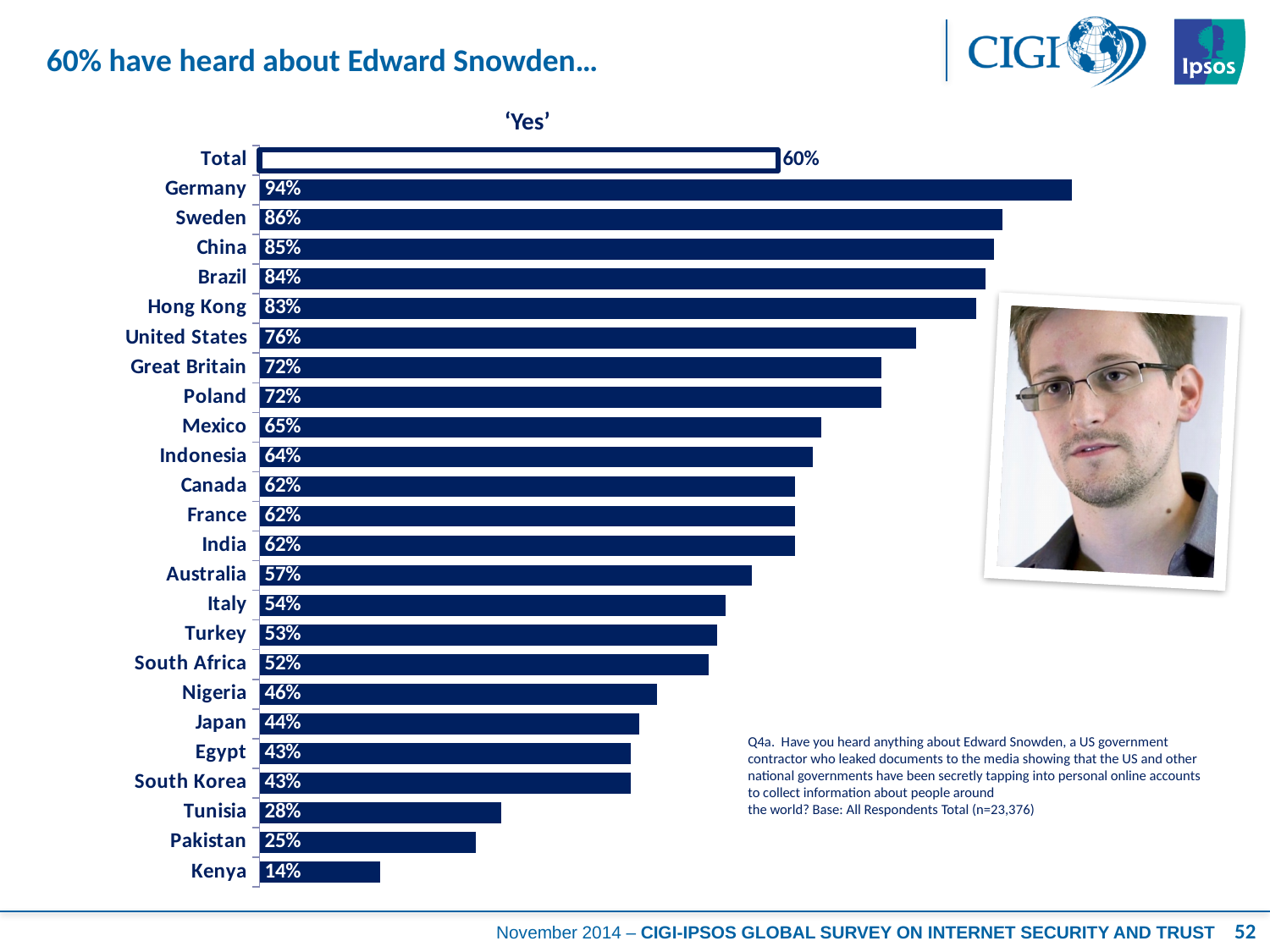
What kind of chart is shown on the slide? Bar chart What percentage is shown for Japan? 44% What is the label shown above the chart? 'Yes' What percentage of respondents in Germany said 'Yes' to having heard about Edward Snowden? 94% What is the difference in percentage points between Sweden and Tunisia? 58 What is the value shown for the Total bar? 60% How many countries (excluding Total) are shown in the chart? 24 Which has a higher value, Pakistan or Tunisia? Tunisia What is the difference in percentage points between Germany and Kenya? 80 Which country has the highest percentage of 'Yes' responses? Germany Which country has the lowest percentage of 'Yes' responses? Kenya Which has a higher value, United States or Great Britain? United States